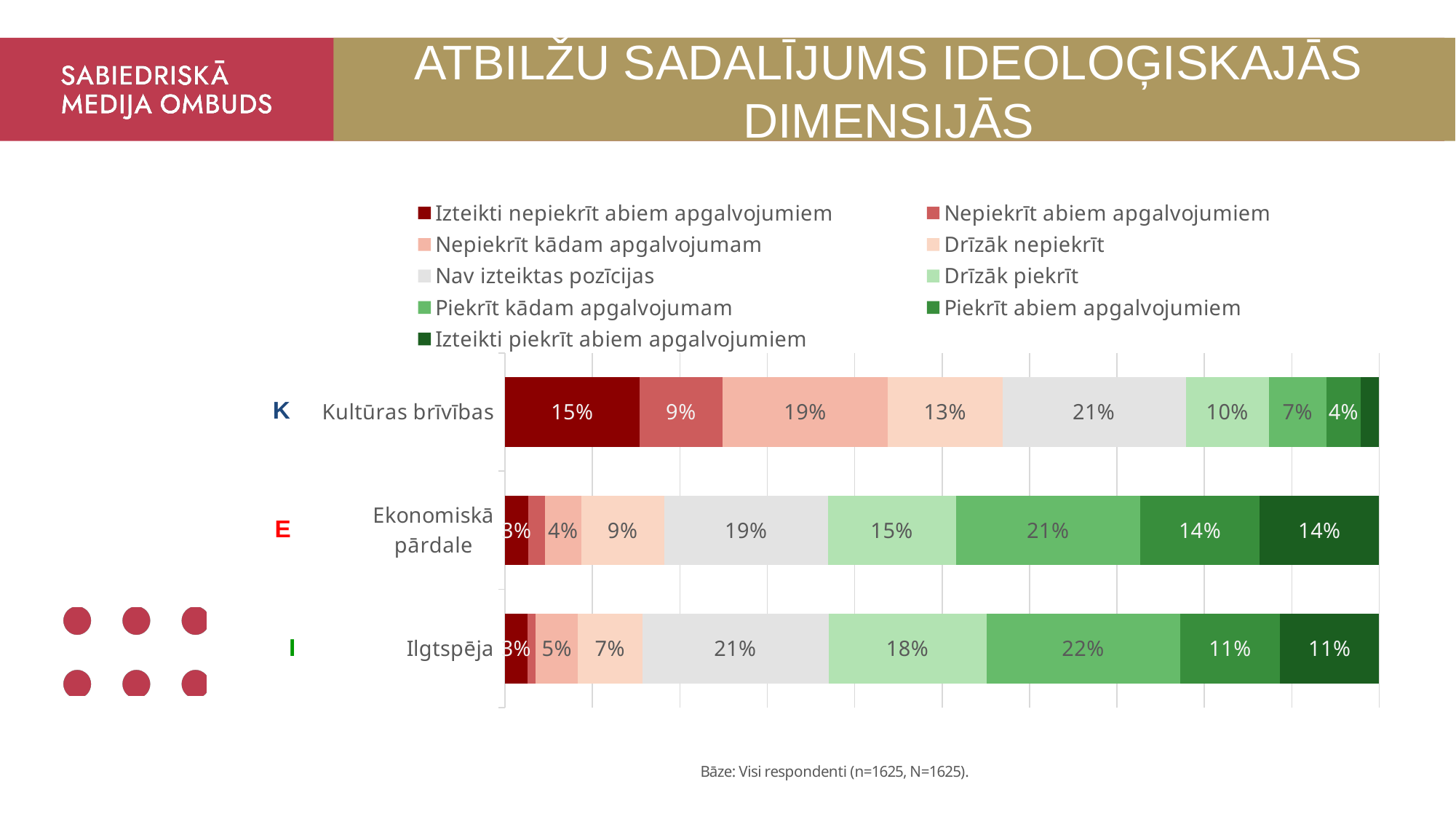
How many categories (dimensions) are plotted on the chart? 3 Which category has the lowest value for 'Piekrīt kādam apgalvojumam'? Kultūras brīvības What is the value of 'Nav izteiktas pozīcijas' for Kultūras brīvības? 21% What is the value of 'Piekrīt kādam apgalvojumam' for Ilgtspēja? 22% How many series does the legend list? 9 What is the difference between 'Nepiekrīt kādam apgalvojumam' for Kultūras brīvības and for Ilgtspēja? 14% Which is larger: 'Drīzāk piekrīt' for Ekonomiskā pārdale or for Ilgtspēja? Ilgtspēja What is the value of 'Izteikti nepiekrīt abiem apgalvojumiem' for Kultūras brīvības? 15% Which category has the highest value for 'Izteikti nepiekrīt abiem apgalvojumiem'? Kultūras brīvības What kind of chart is shown on the slide? Stacked bar chart What is the value of 'Drīzāk piekrīt' for Ilgtspēja? 18% What is the value of 'Izteikti piekrīt abiem apgalvojumiem' for Ekonomiskā pārdale? 14%